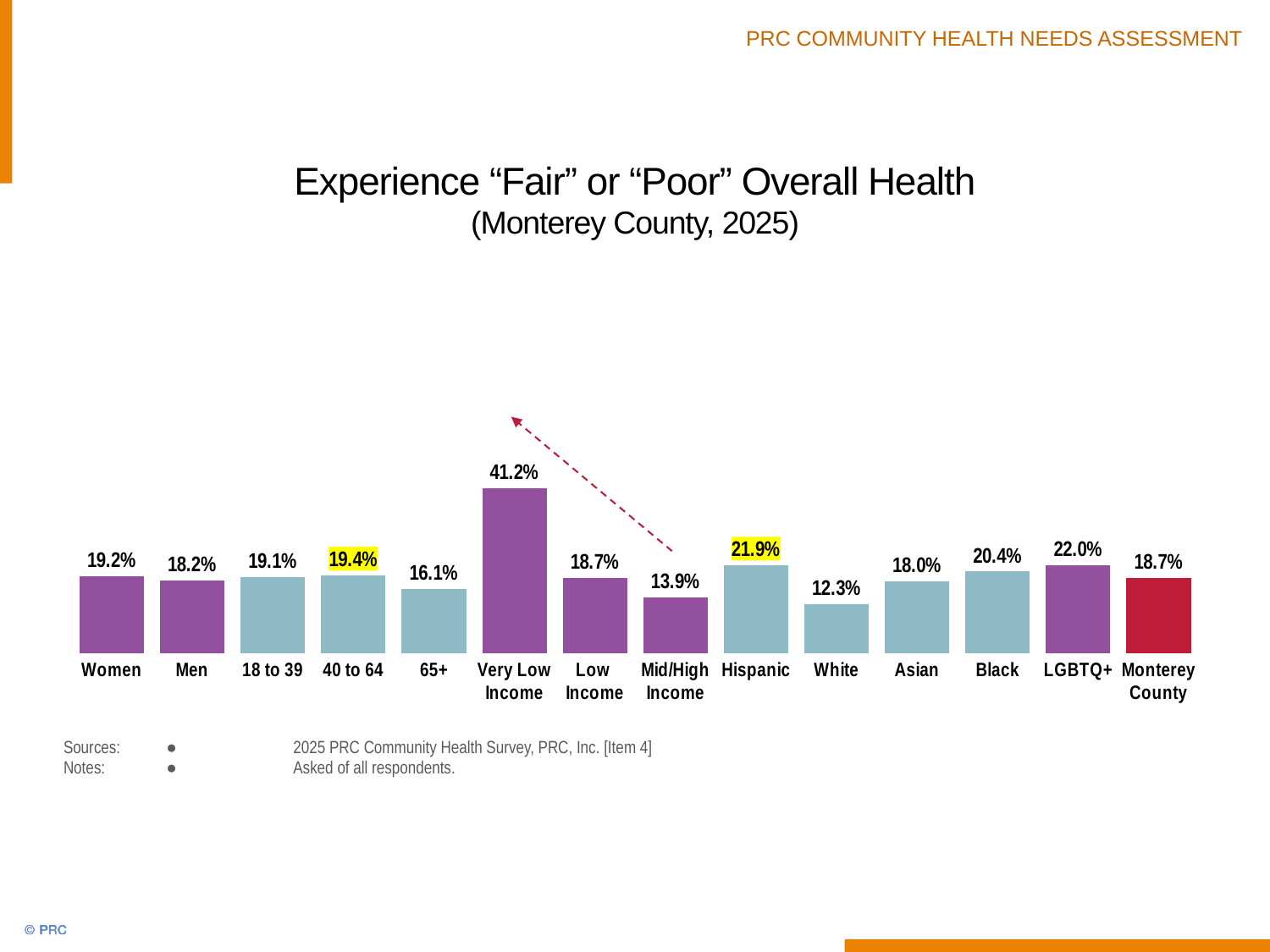
What kind of chart is shown on the slide? Bar chart Which category has the highest value? Very Low Income What is the value for 65+? 16.1% What is the difference between the values for Very Low Income and Mid/High Income? 27.3% Which category has the lowest value? White What is the value for Monterey County? 18.7% Which is larger, the value for Black or the value for Asian? Black Which is larger, the value for Women or the value for Men? Women What is the title of the chart? Experience "Fair" or "Poor" Overall Health (Monterey County, 2025) What is the value for Hispanic? 21.9% How many categories are shown in the chart? 14 What is the value for Very Low Income? 41.2%